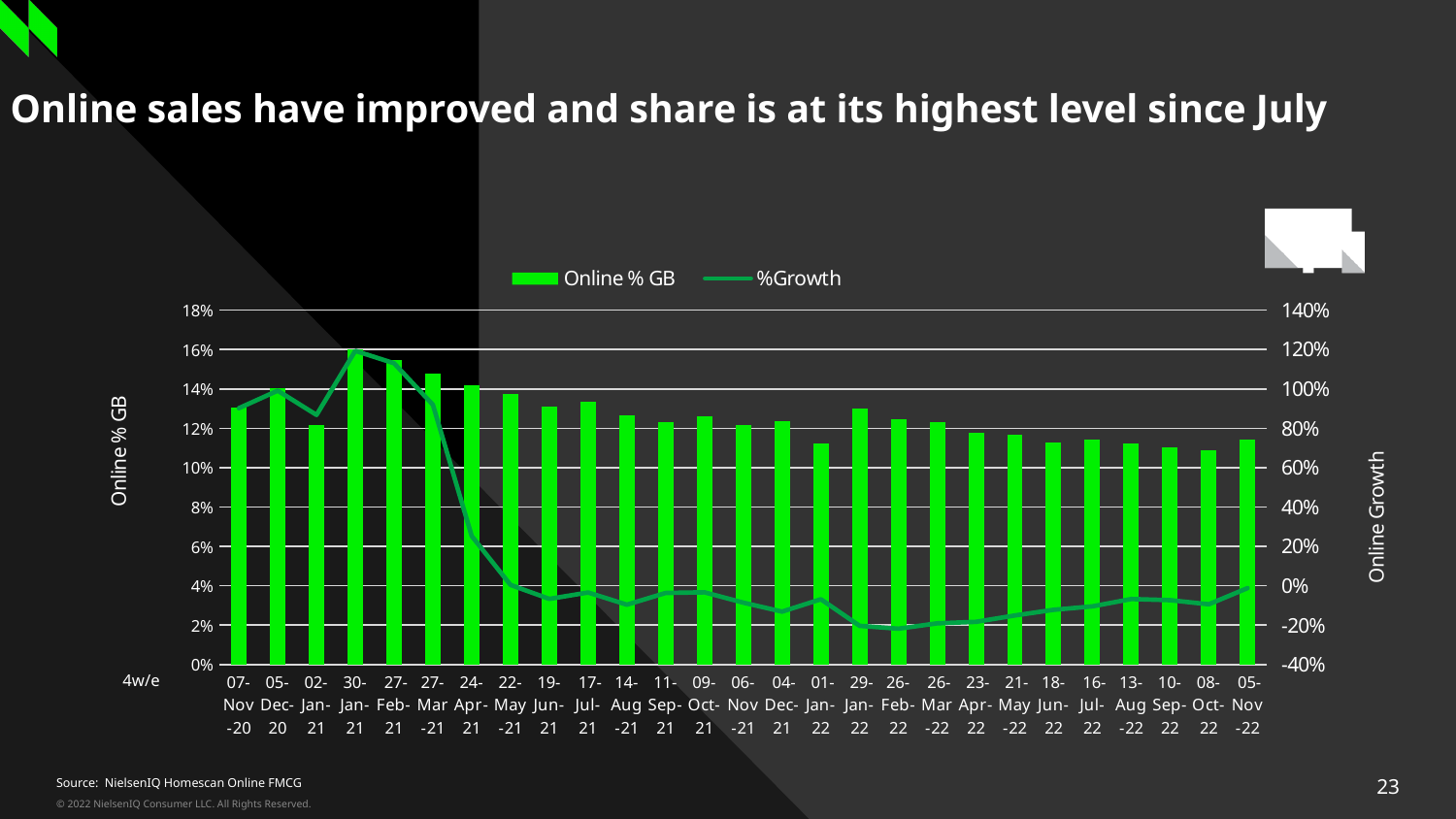
What kind of chart is shown on the slide? A combination bar and line chart Which has the larger Online % GB value, 30-Jan-21 or 05-Nov-22? 30-Jan-21 Is the %Growth value for 30-Jan-21 greater or less than 100%? greater How many series does the legend list? 2 Which series is plotted as bars? Online % GB What is the label on the right-hand vertical axis? Online Growth Does the %Growth line generally rise or fall from left to right across the chart? Fall Which period has the highest Online % GB bar? 30-Jan-21 Is the Online % GB value for 30-Jan-21 greater or less than 14%? greater Is the Online % GB value for 08-Oct-22 greater or less than 12%? less How many 4w/e periods are shown on the x axis? 27